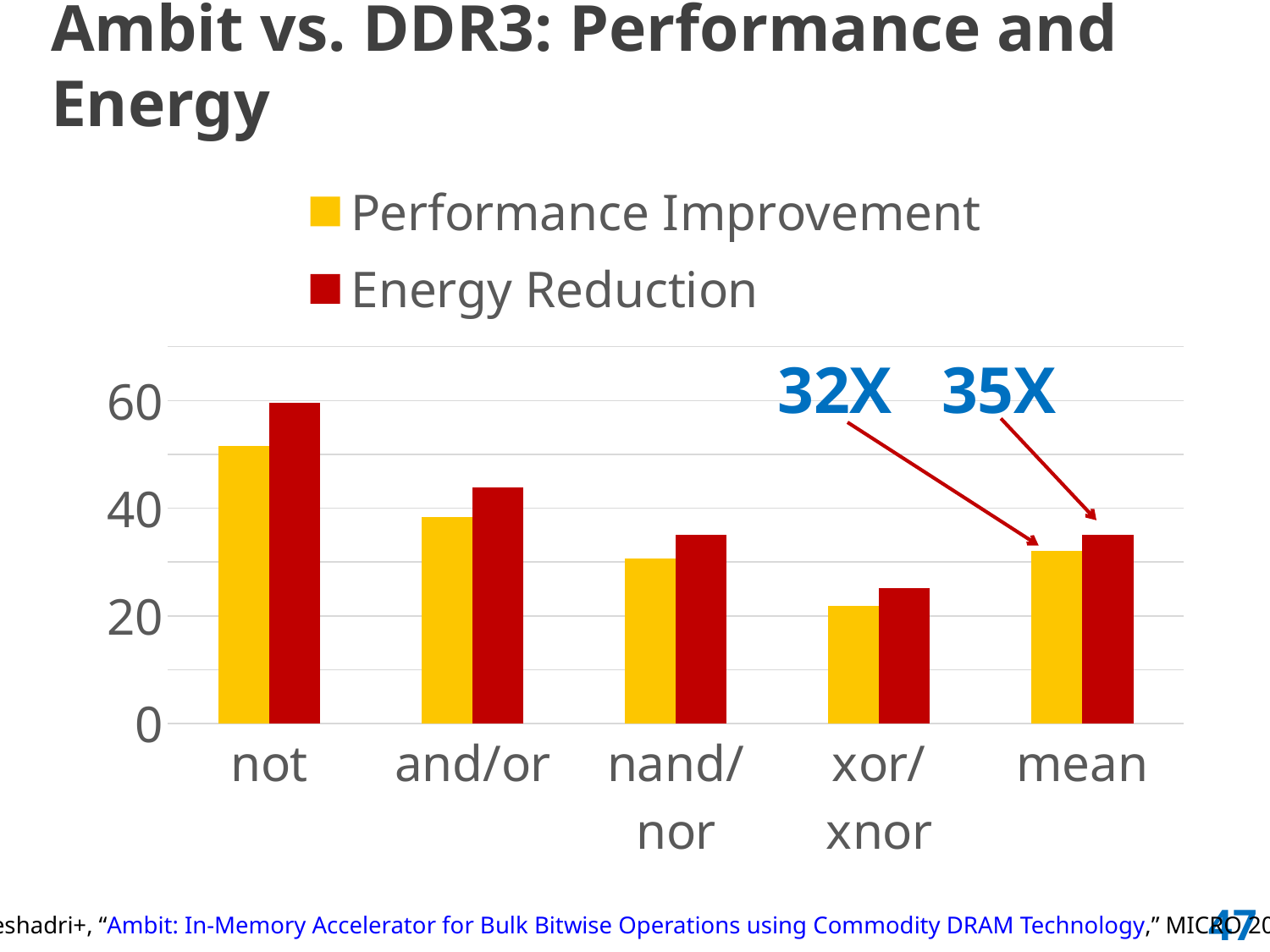
Which category has a larger Performance Improvement bar, not or and/or? not Which colour represents Energy Reduction in the legend? red Is the Energy Reduction value for not greater or less than 40? greater How many series does the legend list? 2 How many categories are shown on the x axis? 5 What is the Energy Reduction value shown for the mean category? 35X What is the difference between the Energy Reduction and Performance Improvement values labelled for the mean category? 3X Which category has the highest Energy Reduction bar? not Which category has the lowest Performance Improvement bar? xor/xnor What kind of chart is shown on the slide? bar chart Is the Performance Improvement value for xor/xnor greater or less than 40? less What is the Performance Improvement value shown for the mean category? 32X